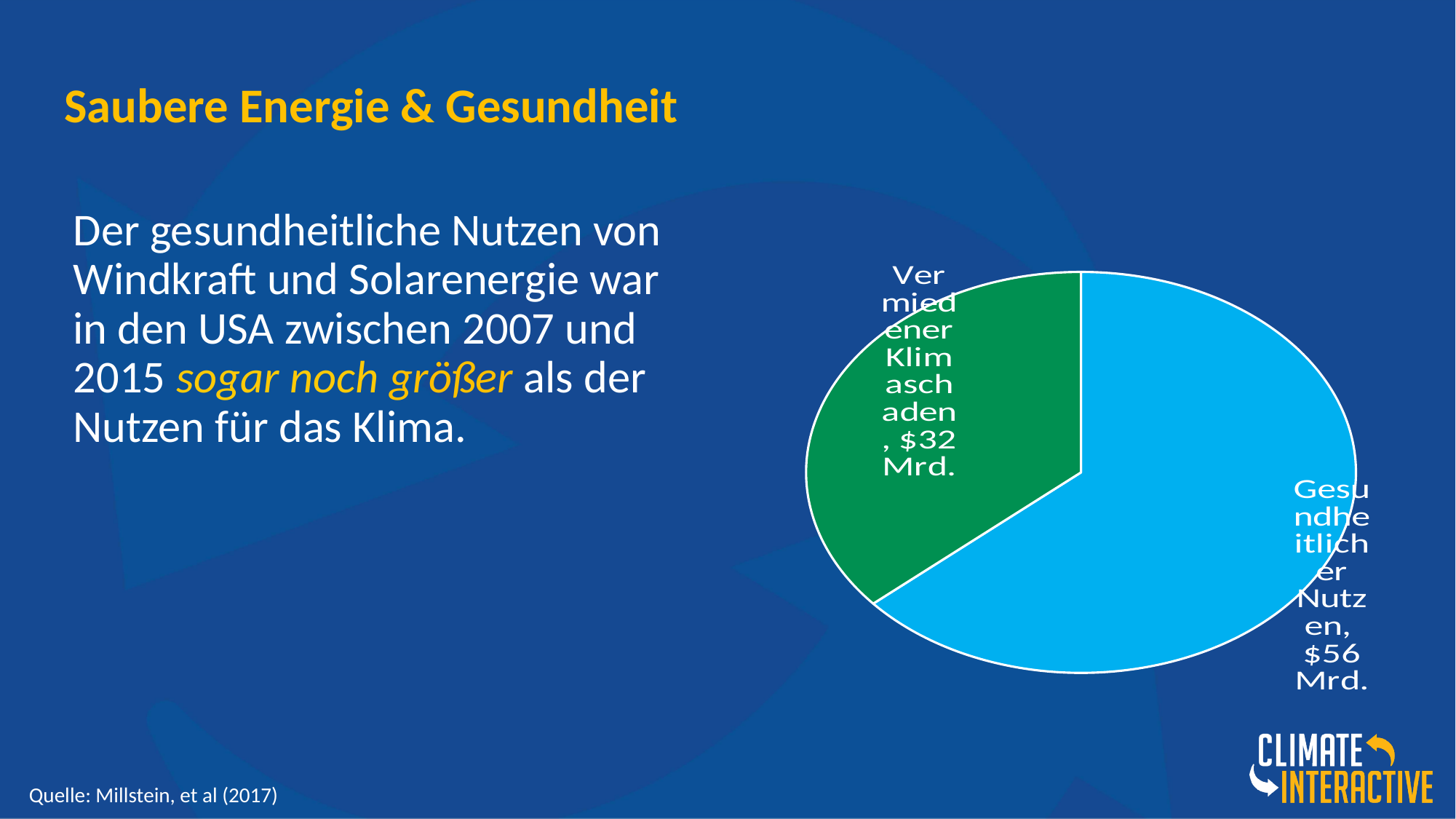
How many slices does the pie chart have? 2 What share of the pie does 'Gesundheitlicher Nutzen' represent? 64% Which slice of the pie chart is the largest? Gesundheitlicher Nutzen What kind of chart is shown on the slide? pie chart What colour is the 'Gesundheitlicher Nutzen' slice? light blue Which is larger, 'Gesundheitlicher Nutzen' or 'Vermiedener Klimaschaden'? Gesundheitlicher Nutzen What is the total of the two slices in the pie chart? $88 Mrd. What is the value of the slice labelled 'Vermiedener Klimaschaden'? $32 Mrd. What colour is the 'Vermiedener Klimaschaden' slice? green What is the difference between the 'Gesundheitlicher Nutzen' and 'Vermiedener Klimaschaden' values? $24 Mrd. What is the value of the slice labelled 'Gesundheitlicher Nutzen'? $56 Mrd. Which slice of the pie chart is the smallest? Vermiedener Klimaschaden